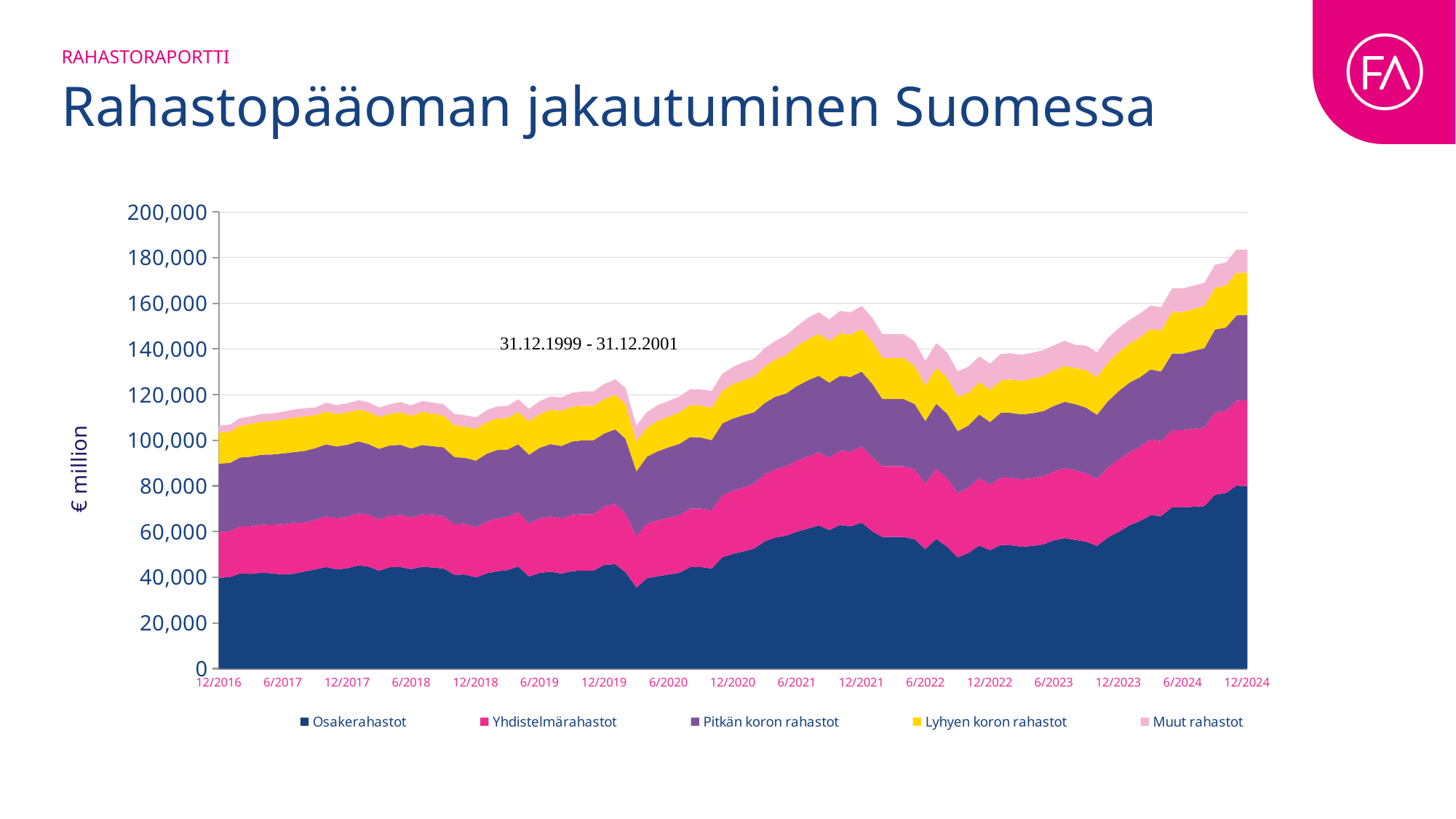
Is the value for Osakerahastot at 12/2024 greater or less than 60,000? greater What is the label on the vertical axis? € million How many series does the legend list? 5 Which series is plotted at the bottom of the stack (dark blue)? Osakerahastot What kind of chart is shown on the slide? Stacked area chart Is the total fund capital at 12/2016 greater or less than 100,000? greater Which series has the largest value at 12/2024? Osakerahastot Which series has the smallest value at 12/2024? Muut rahastot Is the total fund capital at 12/2024 greater or less than 160,000? greater How many date labels are shown on the x axis? 17 Does the total fund capital rise or fall from 12/2016 to 12/2024? rise